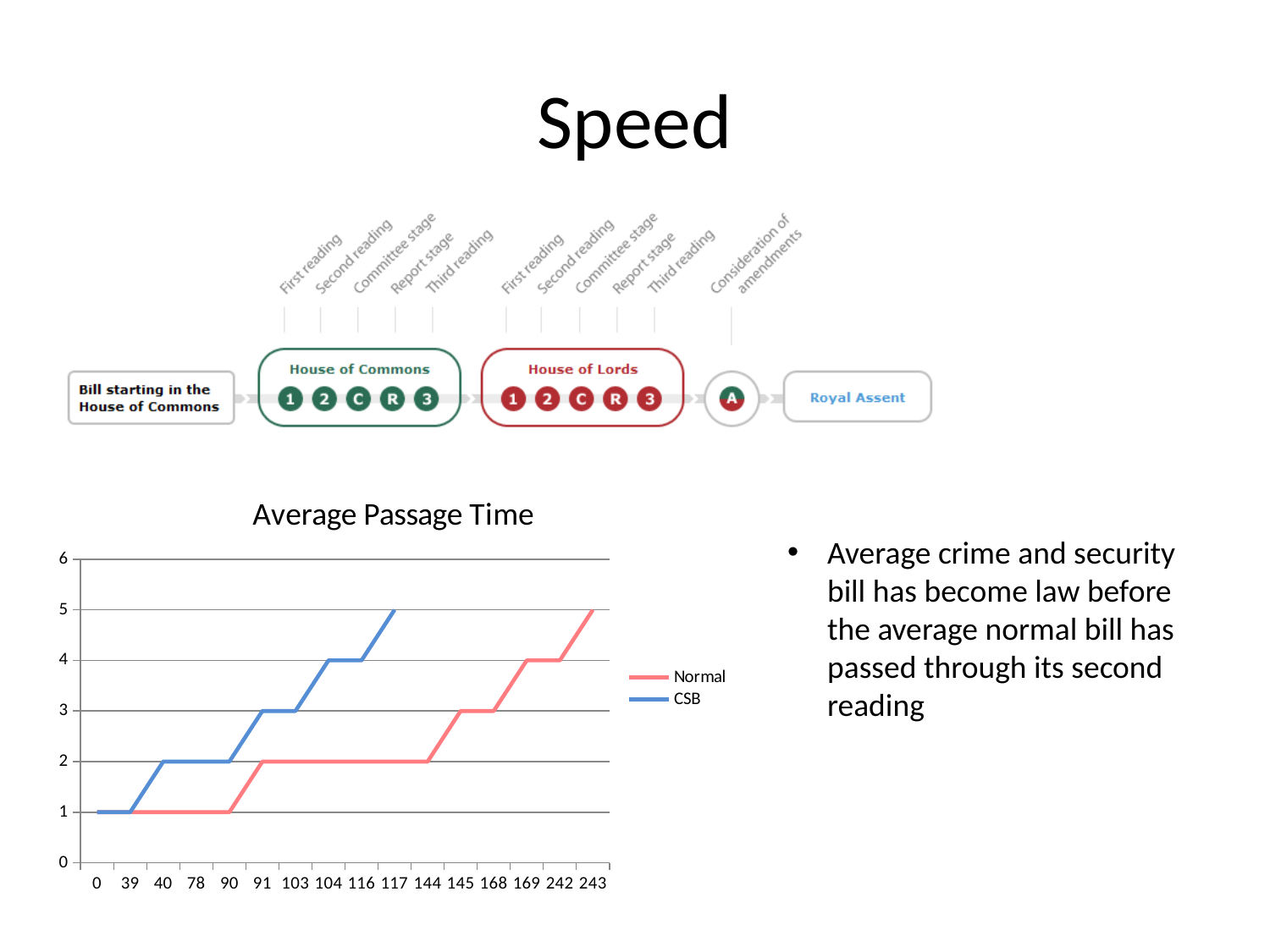
How many categories are shown on the x axis of the "Average Passage Time" chart? 16 In the "Average Passage Time" chart, which series has the higher value at x = 91, Normal or CSB? CSB How many series does the legend of the "Average Passage Time" chart list? 2 In the "Average Passage Time" chart, which colour is used for the CSB series? blue In the "Average Passage Time" chart, do the values of the Normal series rise or fall along the x axis? rise In the "Average Passage Time" chart, what is the value of the CSB series at x = 40? 2 In the "Average Passage Time" chart, what is the value of the CSB series at x = 117? 5 In the "Average Passage Time" chart, what is the value of the Normal series at x = 243? 5 What are the two series named in the legend of the "Average Passage Time" chart? Normal and CSB In the "Average Passage Time" chart, what is the difference between the CSB value and the Normal value at x = 104? 2 In the "Average Passage Time" chart, what is the value of the Normal series at x = 117? 2 What kind of chart is the "Average Passage Time" chart? line chart